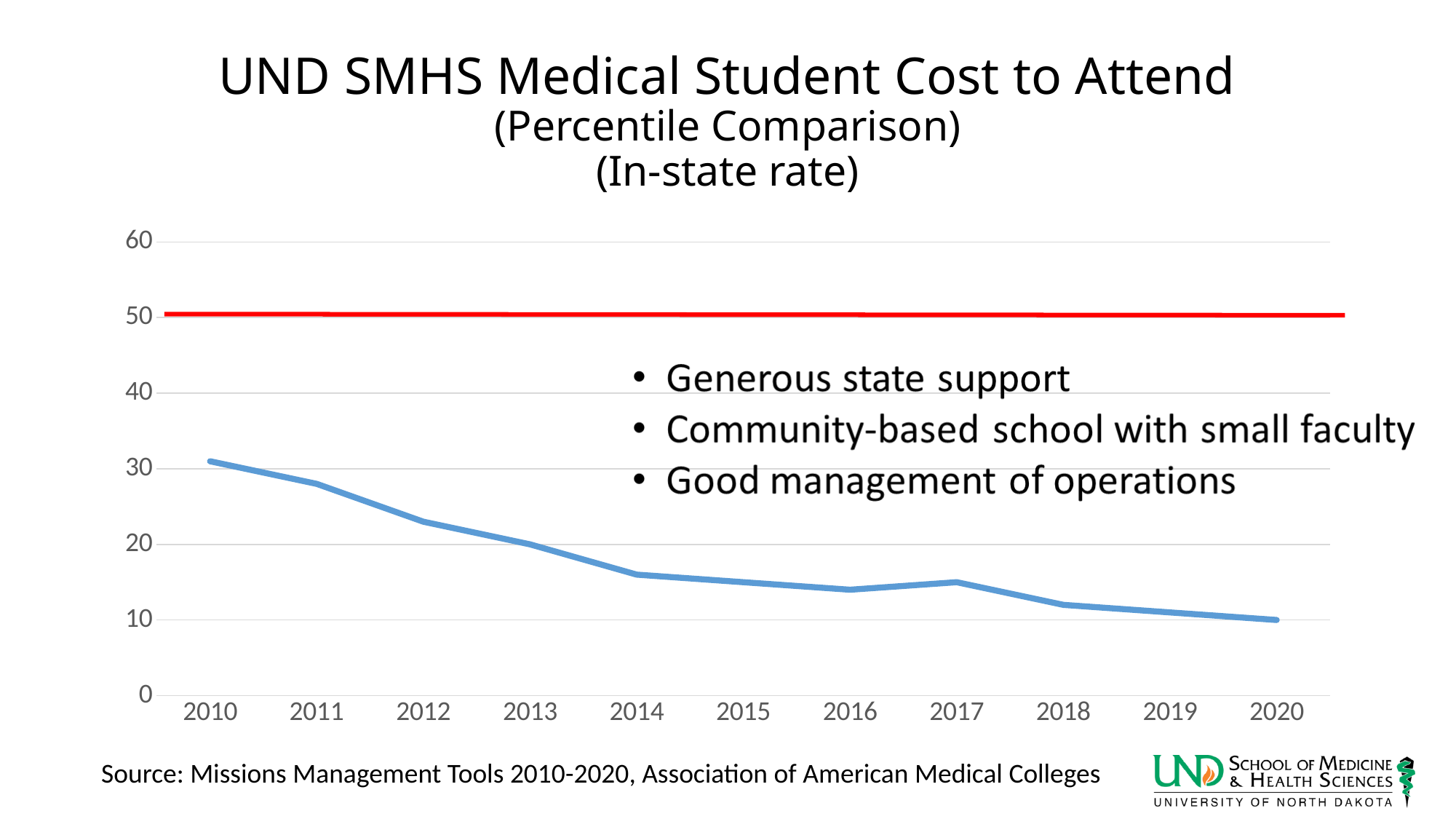
How many years are shown on the x axis of the chart? 11 Is the value of the blue line for 2010 greater or less than 20? greater What kind of chart is shown on the slide? line chart What is the main title of the chart? UND SMHS Medical Student Cost to Attend Is the value of the red line greater or less than 40? greater Which year has the larger value on the blue line, 2013 or 2017? 2013 How many lines are plotted on the chart? 2 Is the value of the blue line for 2020 greater or less than 20? less In which year is the blue line at its lowest value? 2020 In which year is the blue line at its highest value? 2010 Does the blue line rise or fall from 2010 to 2020? fall